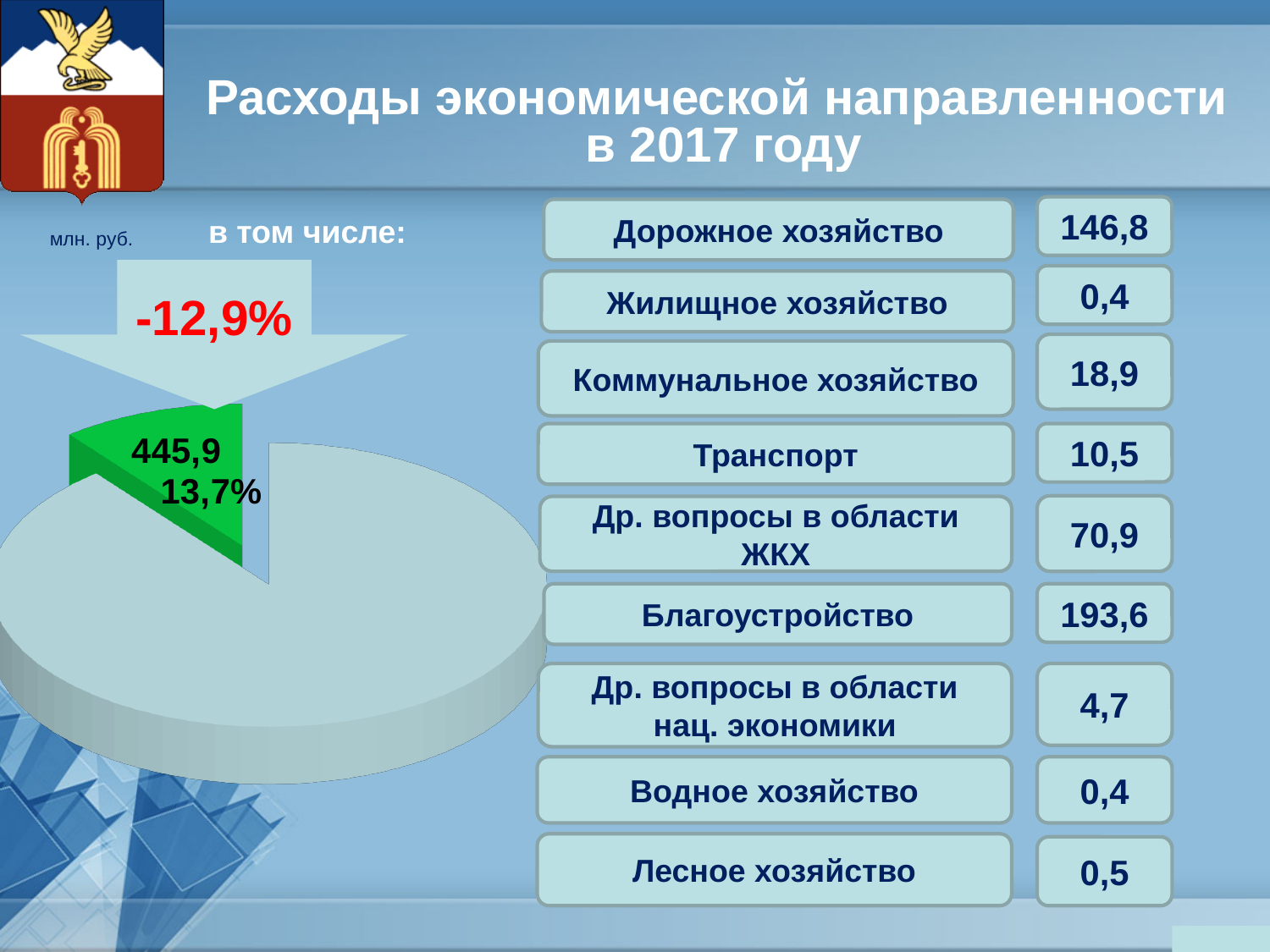
What value is printed on the green slice of the pie chart? 445,9 In the breakdown on the right, what is the value for Благоустройство? 193,6 What share of the pie does the green slice represent? 13,7% In the breakdown on the right, which item has the highest value? Благоустройство In the breakdown on the right, which is larger: Транспорт or Коммунальное хозяйство? Коммунальное хозяйство What percentage change is shown in the arrow above the pie chart? -12,9% In the breakdown on the right, what is the value for Дорожное хозяйство? 146,8 How many slices does the pie chart have? 2 What kind of chart is shown on the left of the slide? pie chart What unit is indicated for the values on the slide? млн. руб. In the breakdown on the right, what is the difference between Благоустройство and Дорожное хозяйство? 46,8 How many items are listed in the breakdown on the right of the slide? 9